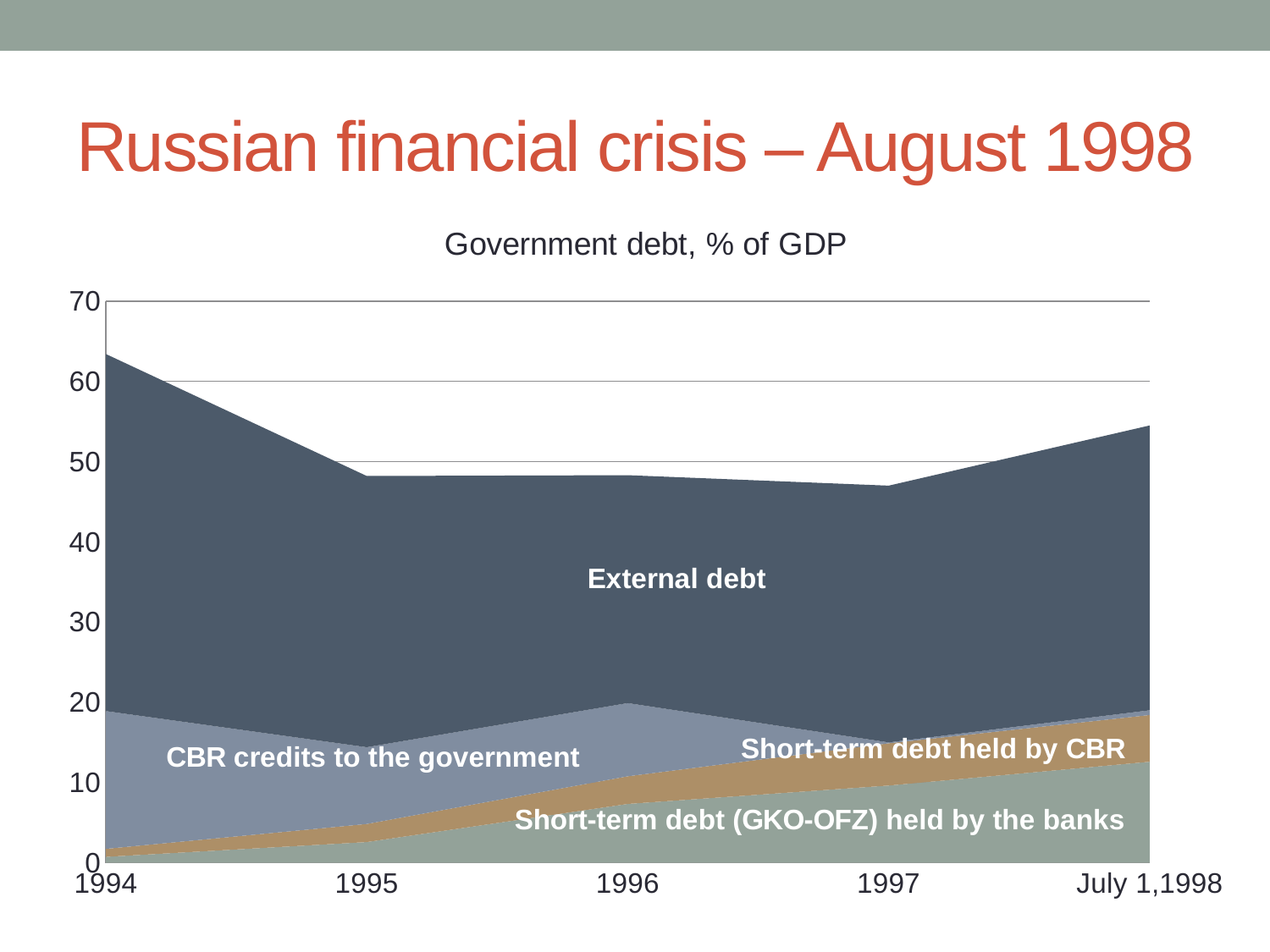
Which is larger: total government debt in 1994 or on July 1, 1998? 1994 How many debt components (series) are labelled in the chart? 4 Is the total government debt in 1994 greater or less than 60? greater Which series occupies the largest area of the chart? External debt What kind of chart is shown on the slide? Area chart How many time points are shown along the x axis of the chart? 5 In which year is total government debt as % of GDP highest? 1994 Is the total government debt on July 1, 1998 greater or less than 50? greater What is the title of the chart? Government debt, % of GDP Does total government debt rise or fall from 1994 to 1995? fall Is the total government debt in 1995 greater or less than 50? less